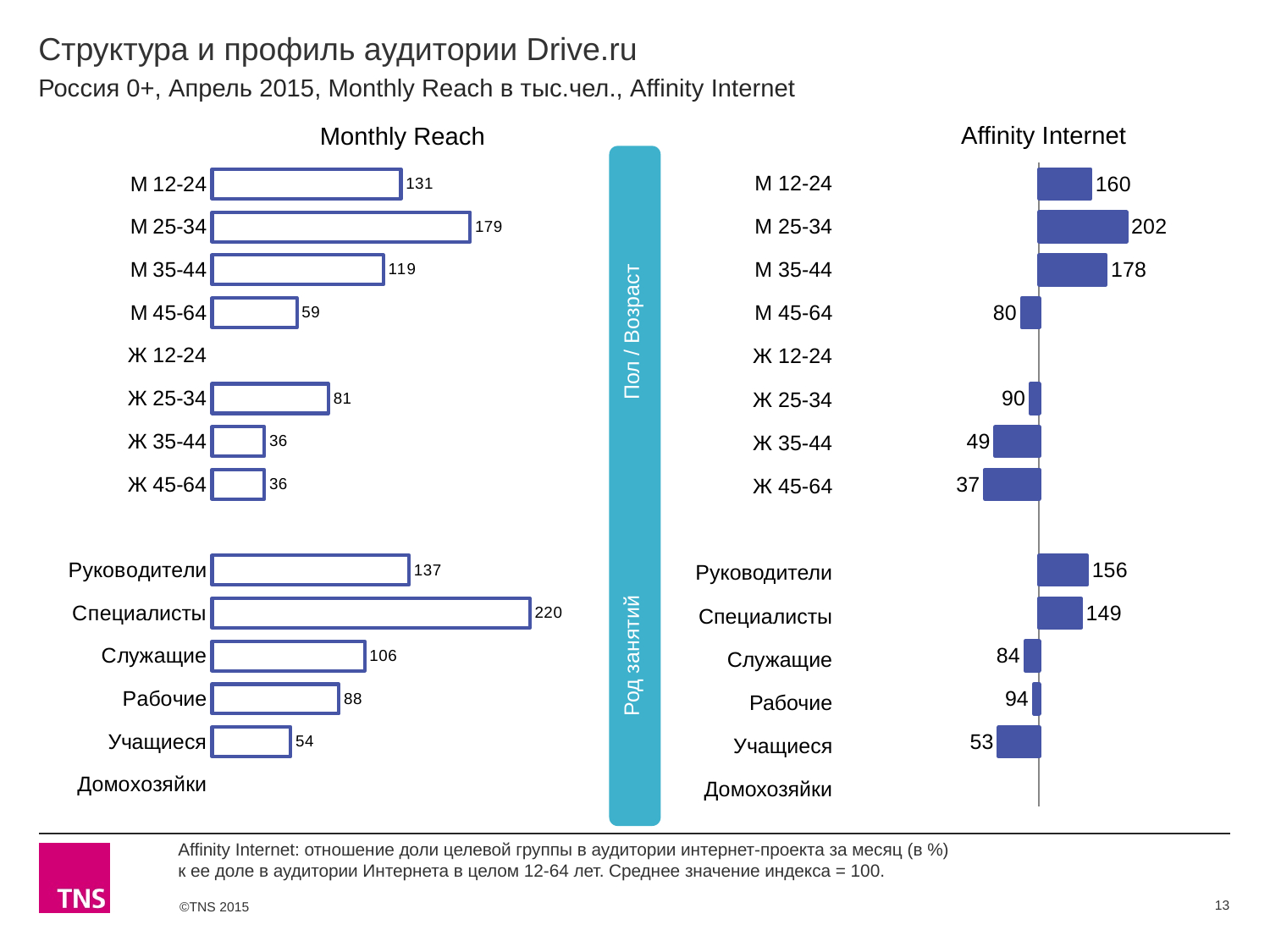
On the Affinity Internet chart, what is the difference between Руководители and Специалисты? 7 On the Affinity Internet chart, which category has the highest value? М 25-34 What type of chart is the Monthly Reach chart? Bar chart On the Monthly Reach chart, what is the difference between М 25-34 and М 12-24? 48 On the Monthly Reach chart, which category has the highest value? Специалисты On the Monthly Reach chart, which is larger: Руководители or Служащие? Руководители On the Affinity Internet chart, which category has the lowest labelled value? Ж 45-64 On the Affinity Internet chart, which is larger: Рабочие or Служащие? Рабочие On the Affinity Internet chart, what is the value for М 35-44? 178 On the Monthly Reach chart, what is the value for М 25-34? 179 On the Affinity Internet chart, what is the value for Учащиеся? 53 On the Monthly Reach chart, what is the value for Специалисты? 220